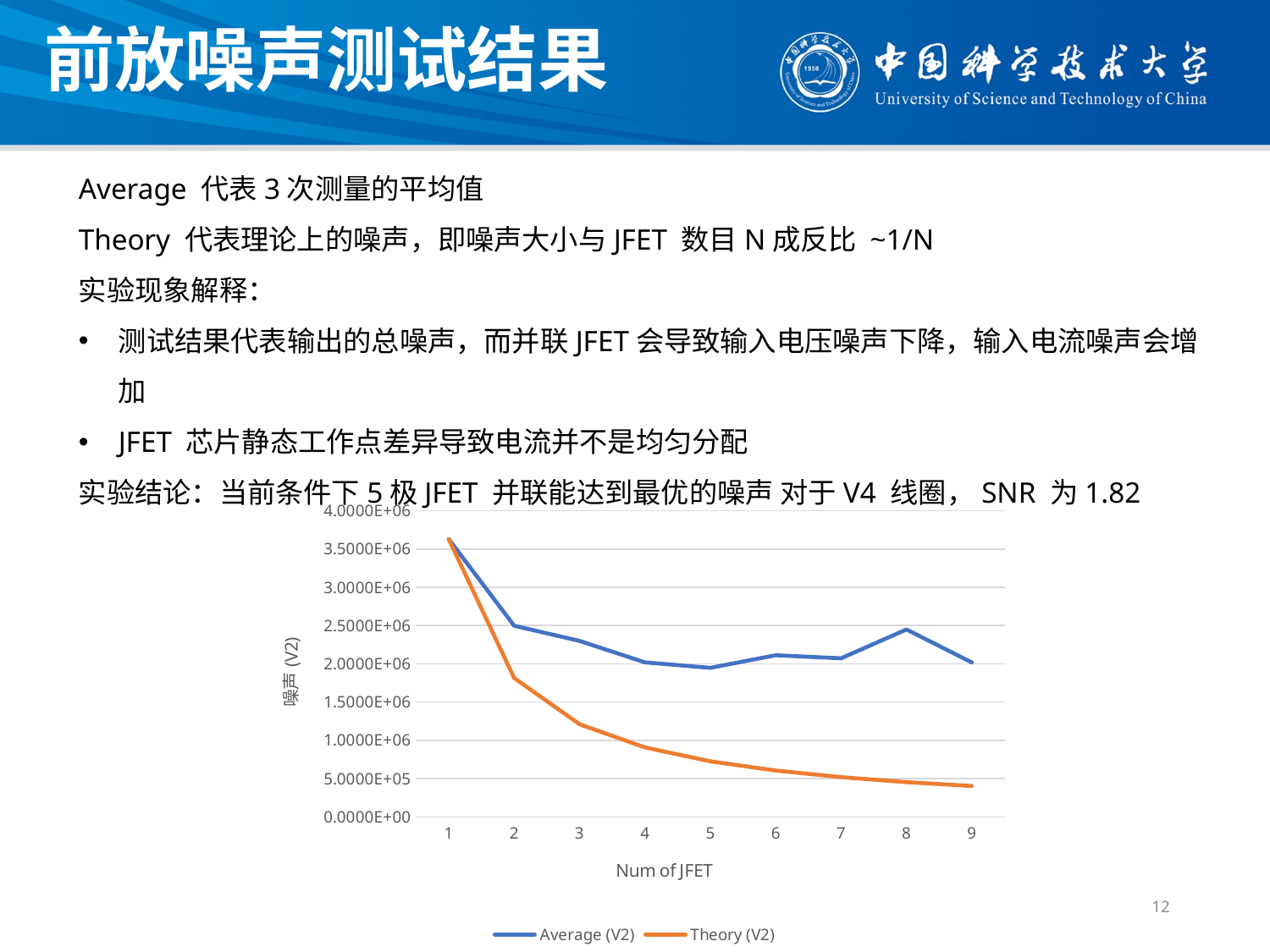
How many Num of JFET values are plotted along the x axis? 9 For the Average (V2) series, is the value at Num of JFET 8 larger or smaller than the value at Num of JFET 9? larger Is the Average (V2) value at Num of JFET 2 greater or less than 2.0000E+06? greater How many series does the chart legend list? 2 Is the Theory (V2) value at Num of JFET 9 greater or less than 5.0000E+05? less At Num of JFET 5, which series has the larger value, Average (V2) or Theory (V2)? Average (V2) What kind of chart is shown on the slide? line chart Does the Theory (V2) series rise or fall as Num of JFET increases from 1 to 9? fall At which Num of JFET is the Theory (V2) series lowest? 9 At which Num of JFET is the Average (V2) series highest? 1 Is the Theory (V2) value at Num of JFET 3 greater or less than 1.5000E+06? less What is the title of the x axis of the chart? Num of JFET